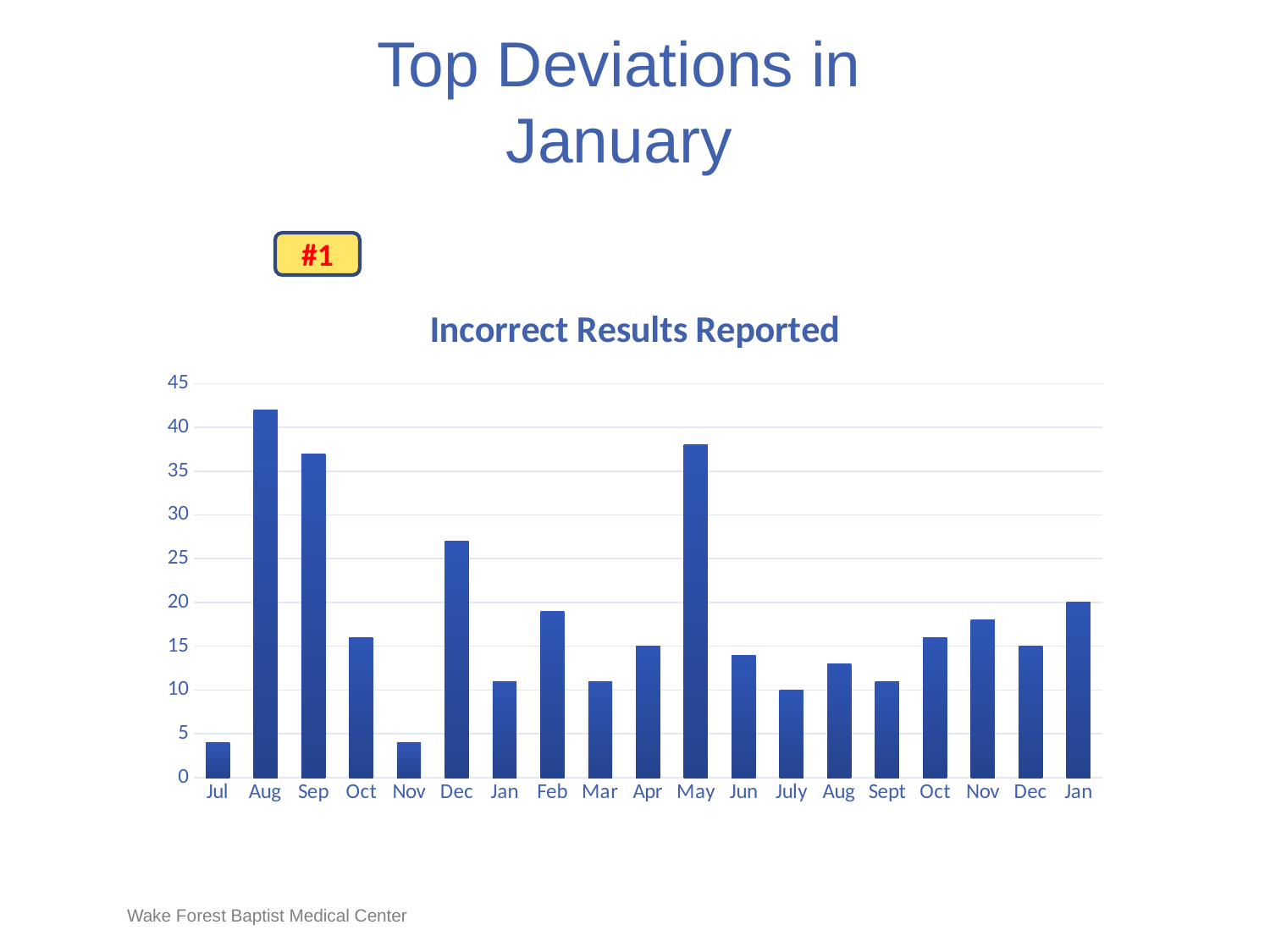
What is the title of the chart? Incorrect Results Reported Is the value for the first Aug bar greater or less than 40? greater Is the value for Jul (the first bar) greater or less than 5? less Is the value for May greater or less than 40? less Which is larger, the value for May or the value for Jun? May Which is larger, the value for Sep or the value for the first Dec bar? Sep Which month has the highest value in the chart? Aug (the first Aug) What kind of chart is shown on the slide? bar chart How many bars (months) are plotted in the chart? 19 What label is shown in the yellow box above the chart? #1